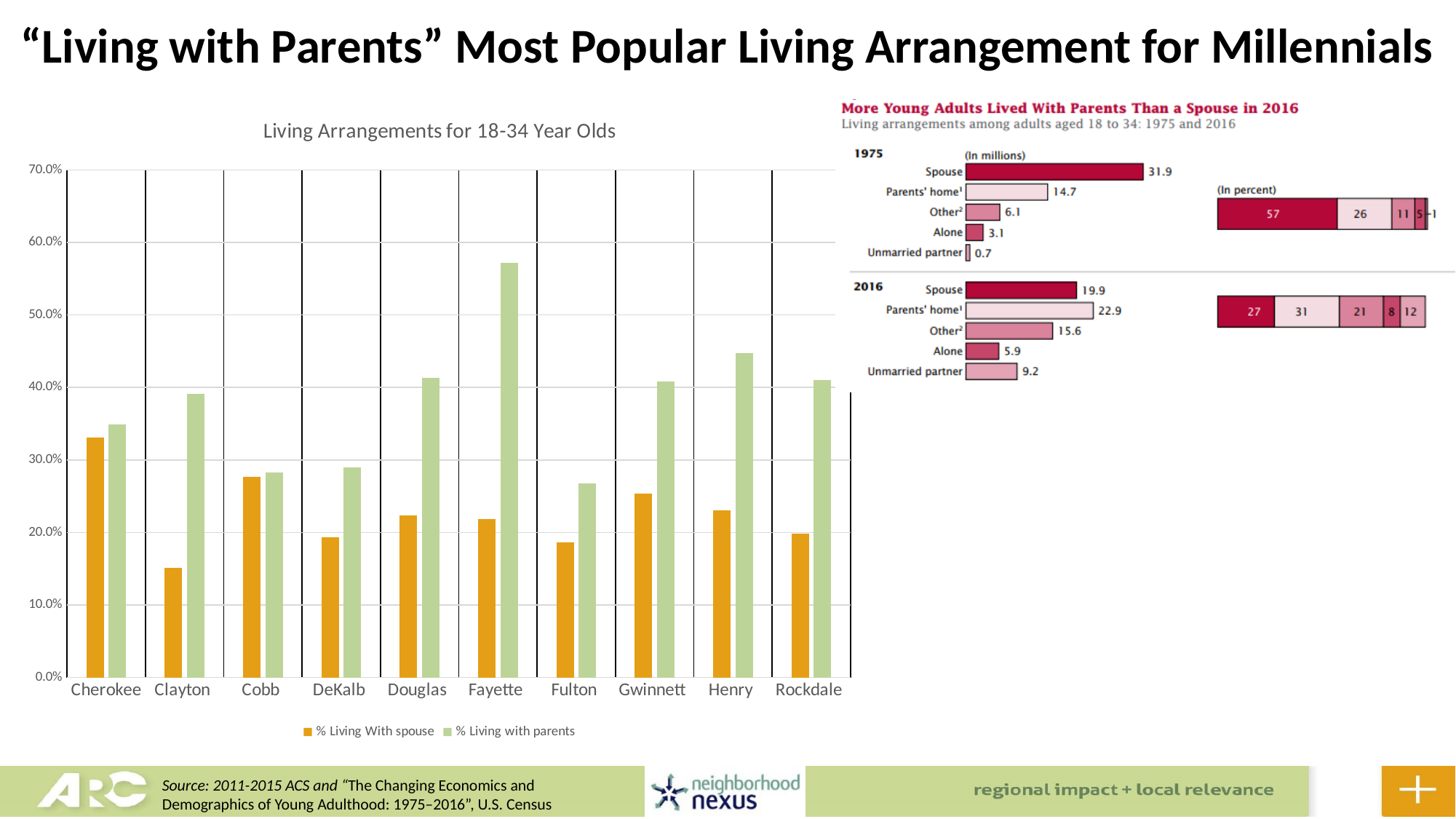
In the chart titled "Living Arrangements for 18-34 Year Olds", which is larger for Henry: % Living With spouse or % Living with parents? % Living with parents In the chart on the right, "More Young Adults Lived With Parents Than a Spouse in 2016", how many millions of young adults lived with a spouse in 1975? 31.9 In the chart titled "Living Arrangements for 18-34 Year Olds", which county has the lowest value for % Living With spouse? Clayton In the chart titled "Living Arrangements for 18-34 Year Olds", is the % Living with parents value for Fayette greater or less than 50.0%? greater What type of chart is "Living Arrangements for 18-34 Year Olds"? bar chart In the chart titled "Living Arrangements for 18-34 Year Olds", is the % Living With spouse value for Clayton greater or less than 20.0%? less In the chart on the right, "More Young Adults Lived With Parents Than a Spouse in 2016", how many millions of young adults lived in their parents' home in 2016? 22.9 How many series does the legend list in the chart titled "Living Arrangements for 18-34 Year Olds"? 2 How many counties are shown in the chart titled "Living Arrangements for 18-34 Year Olds"? 10 In the chart on the right, "More Young Adults Lived With Parents Than a Spouse in 2016", what percent of young adults lived with a spouse in 1975? 57 In the chart on the right, "More Young Adults Lived With Parents Than a Spouse in 2016", what is the difference in millions between Spouse in 1975 and Spouse in 2016? 12.0 In the chart titled "Living Arrangements for 18-34 Year Olds", which county has the highest value for % Living with parents? Fayette